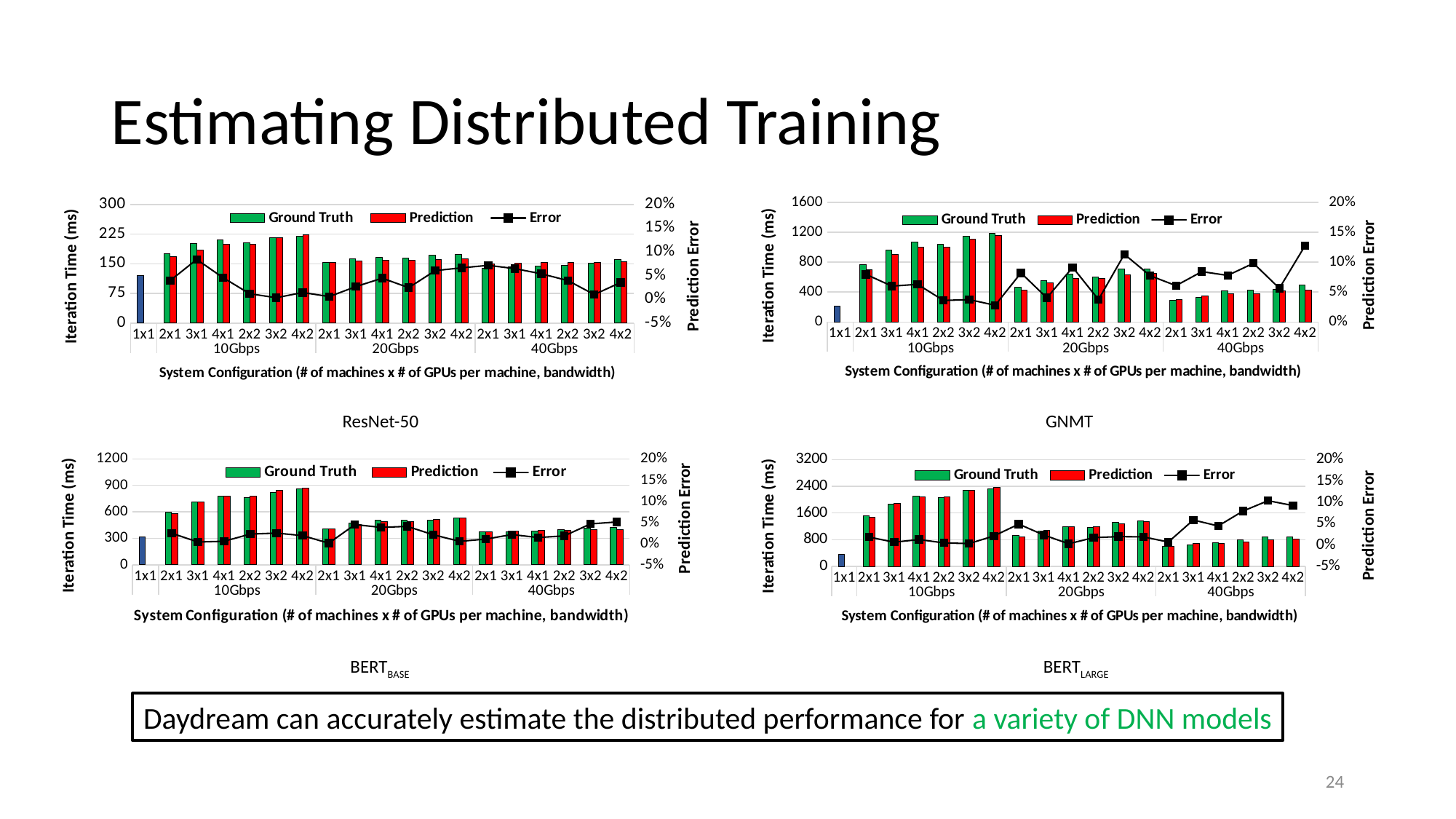
What kind of chart is the BERT_BASE chart? Bar chart with a line series In the GNMT chart, what are the three legend entries? Ground Truth, Prediction, Error In the BERT_BASE chart, is the Ground Truth iteration time for 4x2 at 10Gbps greater or less than 600 ms? greater In the ResNet-50 chart, is the Ground Truth iteration time for the 1x1 configuration greater or less than 150 ms? less In the BERT_LARGE chart, is the Ground Truth iteration time for 1x1 greater or less than 800 ms? less In the GNMT chart, does the Ground Truth iteration time rise or fall from 2x1 to 4x2 within the 10Gbps group? rise How many system configurations are shown on the x axis of the BERT_LARGE chart? 19 In the ResNet-50 chart, how many series does the legend list? 3 In the ResNet-50 chart, which system configuration has the highest Ground Truth iteration time? 4x2 at 10Gbps